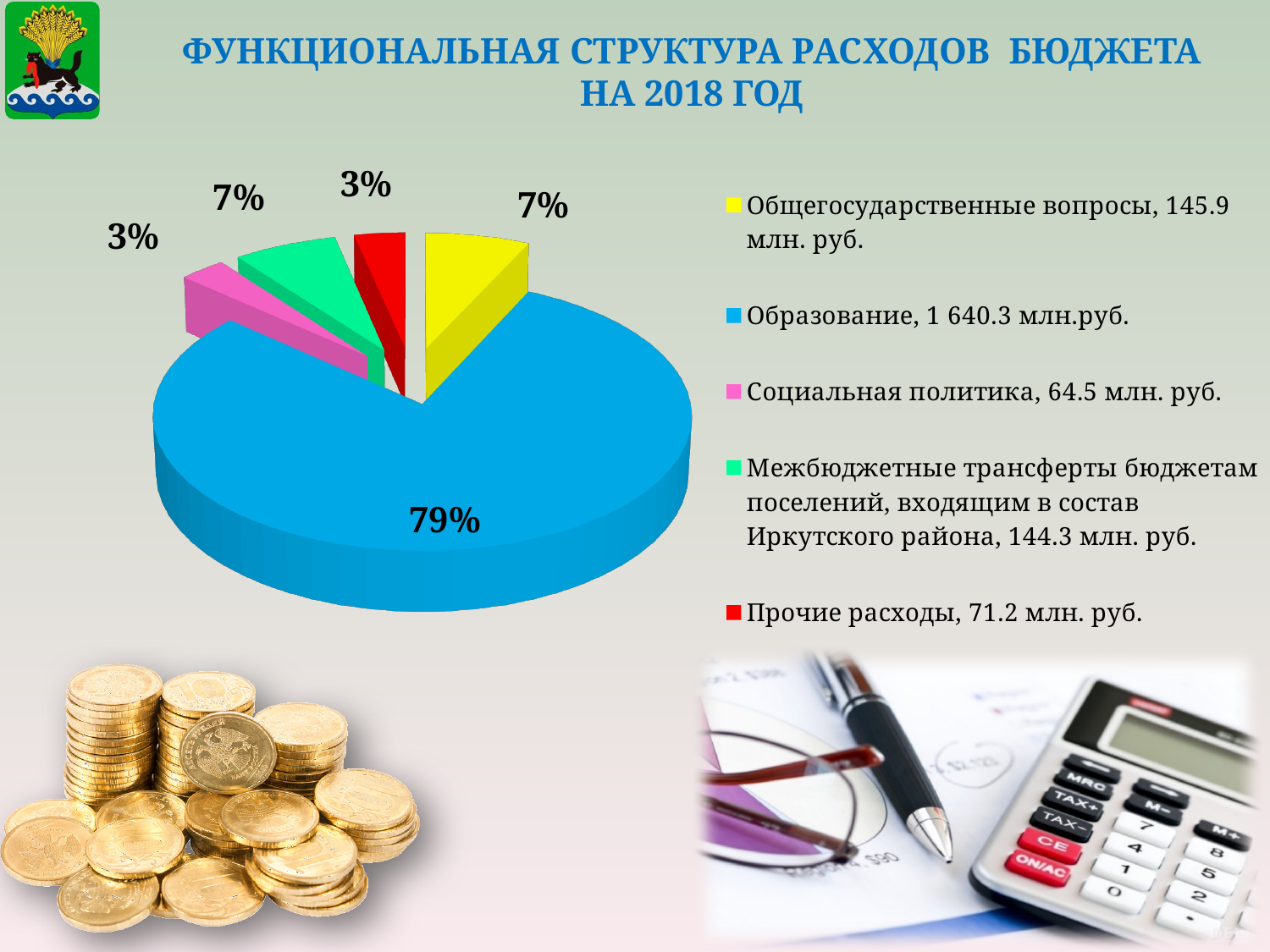
What colour is the slice for Образование? Blue What amount does the legend give for Прочие расходы? 71.2 млн. руб. What amount does the legend give for Образование? 1 640.3 млн.руб. What share of the pie does Образование take? 79% What share of the pie does Социальная политика take? 3% By how many percentage points does the share of Образование exceed the share of Межбюджетные трансферты бюджетам поселений? 72 percentage points Which is larger: the share for Общегосударственные вопросы or the share for Прочие расходы? Общегосударственные вопросы Which category has the largest slice of the pie? Образование What kind of chart is shown on the slide? Pie chart According to the legend, which category has the smallest amount in млн. руб.? Социальная политика What share of the pie does Общегосударственные вопросы take? 7% How many categories does the pie chart have? 5